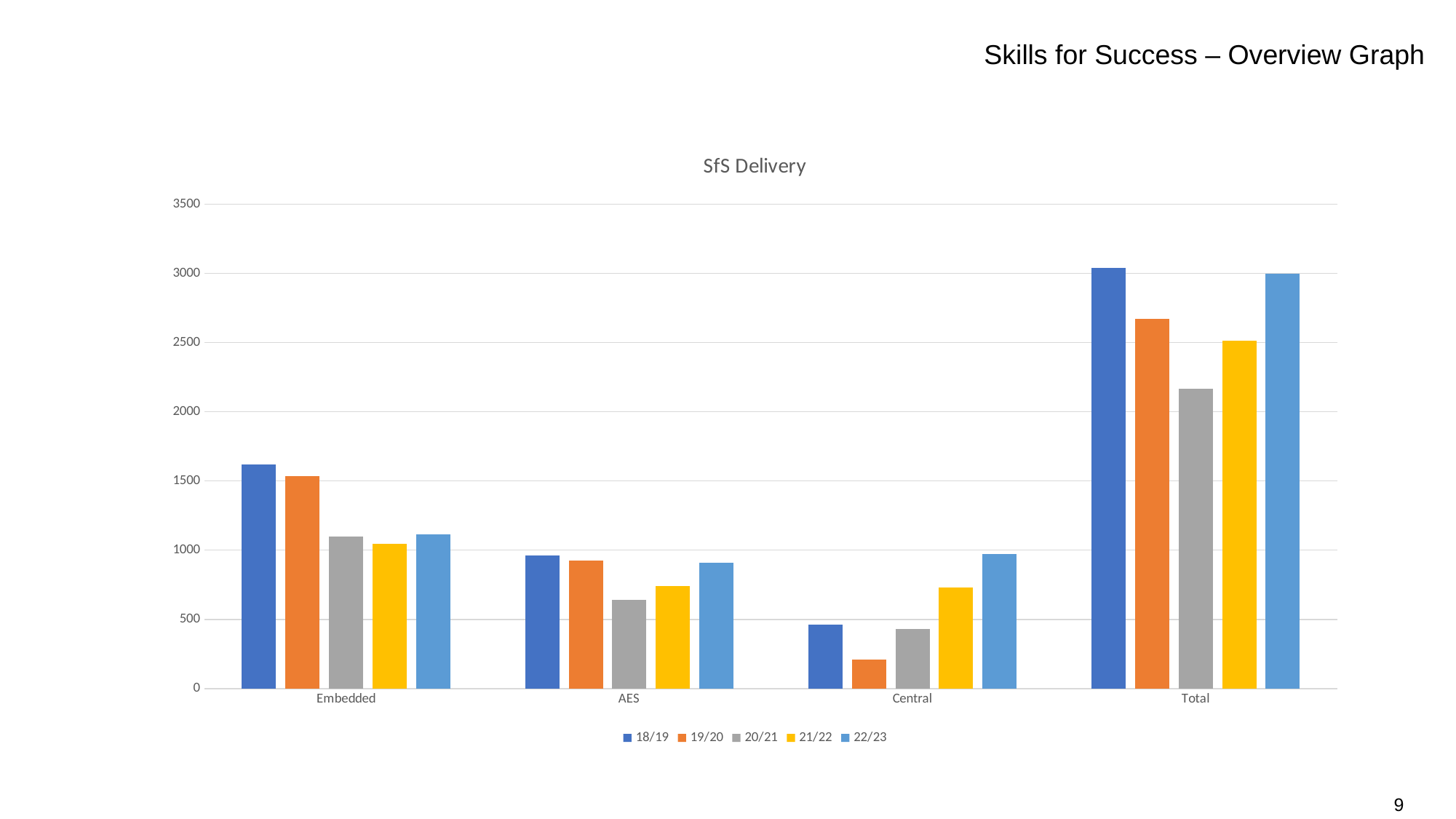
Is the value for 19/20 in the Central category greater or less than 500? less Is the value for 21/22 in the Central category greater or less than 500? greater Is the value for 18/19 in the Embedded category greater or less than 1500? greater How many series does the legend list? 5 Which series has the lowest value in the AES category? 20/21 Which colour represents the 21/22 series in the legend? Yellow What type of chart is shown on the slide? Bar chart What is the title of the chart? SfS Delivery Which is larger: the 19/20 value for Central or the 20/21 value for Central? 20/21 Which series has the highest value in the Central category? 22/23 How many categories are shown on the x axis? 4